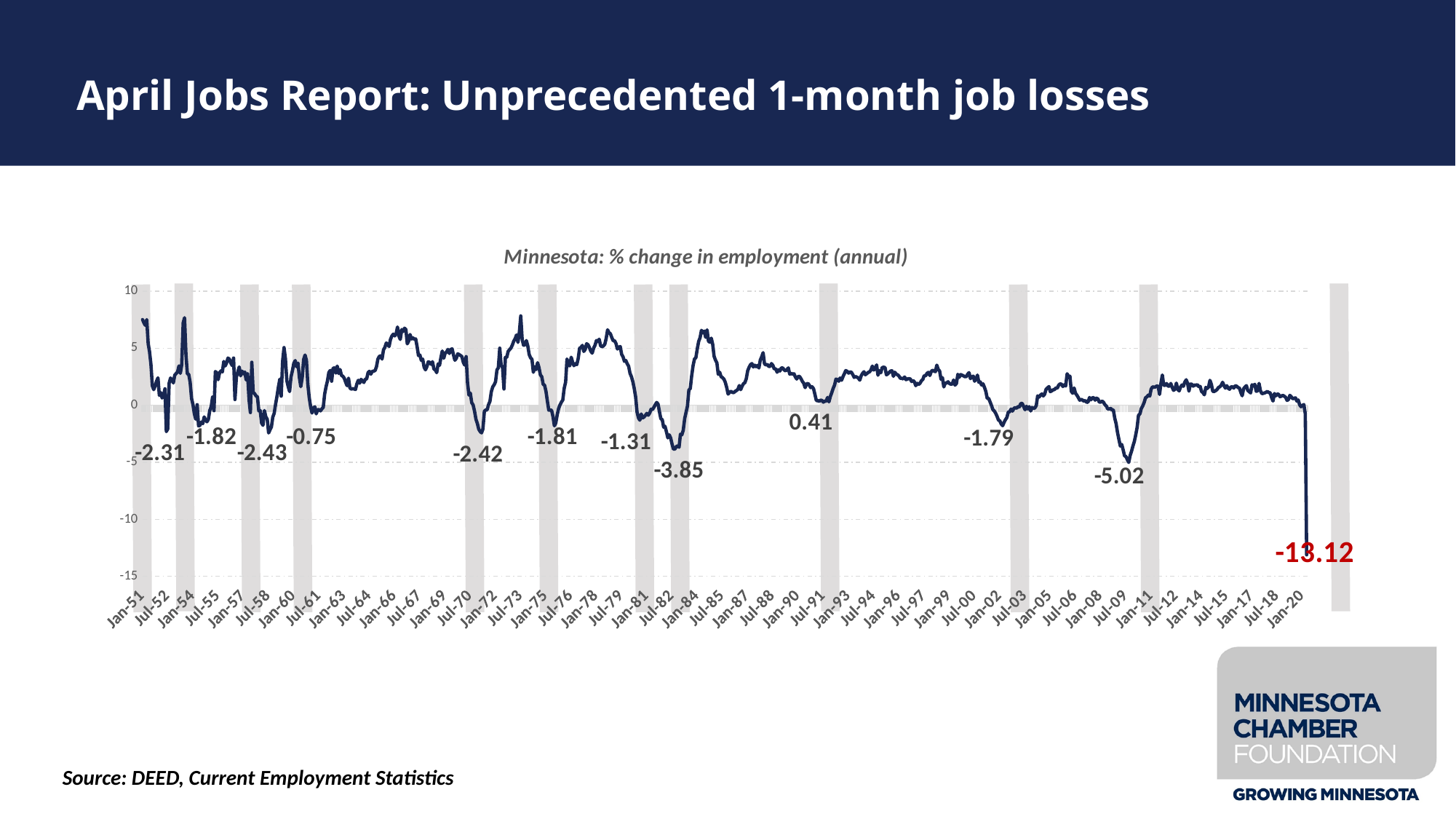
What is the labeled value near Jan-91? 0.41 Which labeled value on the chart is the highest? 0.41 What is the labeled trough value near Jan-02? -1.79 What is the labeled value at the final drop of the line, around Jan-20? -13.12 How many data labels are printed on the chart? 12 Which labeled value on the chart is the lowest? -13.12 What kind of chart is shown on the slide? Line chart Which is lower: the labeled trough near Jul-82 or the labeled trough near Jul-09? Jul-09 (-5.02) What is the labeled trough value near Jul-09? -5.02 What is the difference between the labeled trough near Jul-09 (-5.02) and the final labeled value (-13.12)? 8.10 What is the title of the chart? Minnesota: % change in employment (annual) What is the labeled trough value near Jul-82? -3.85